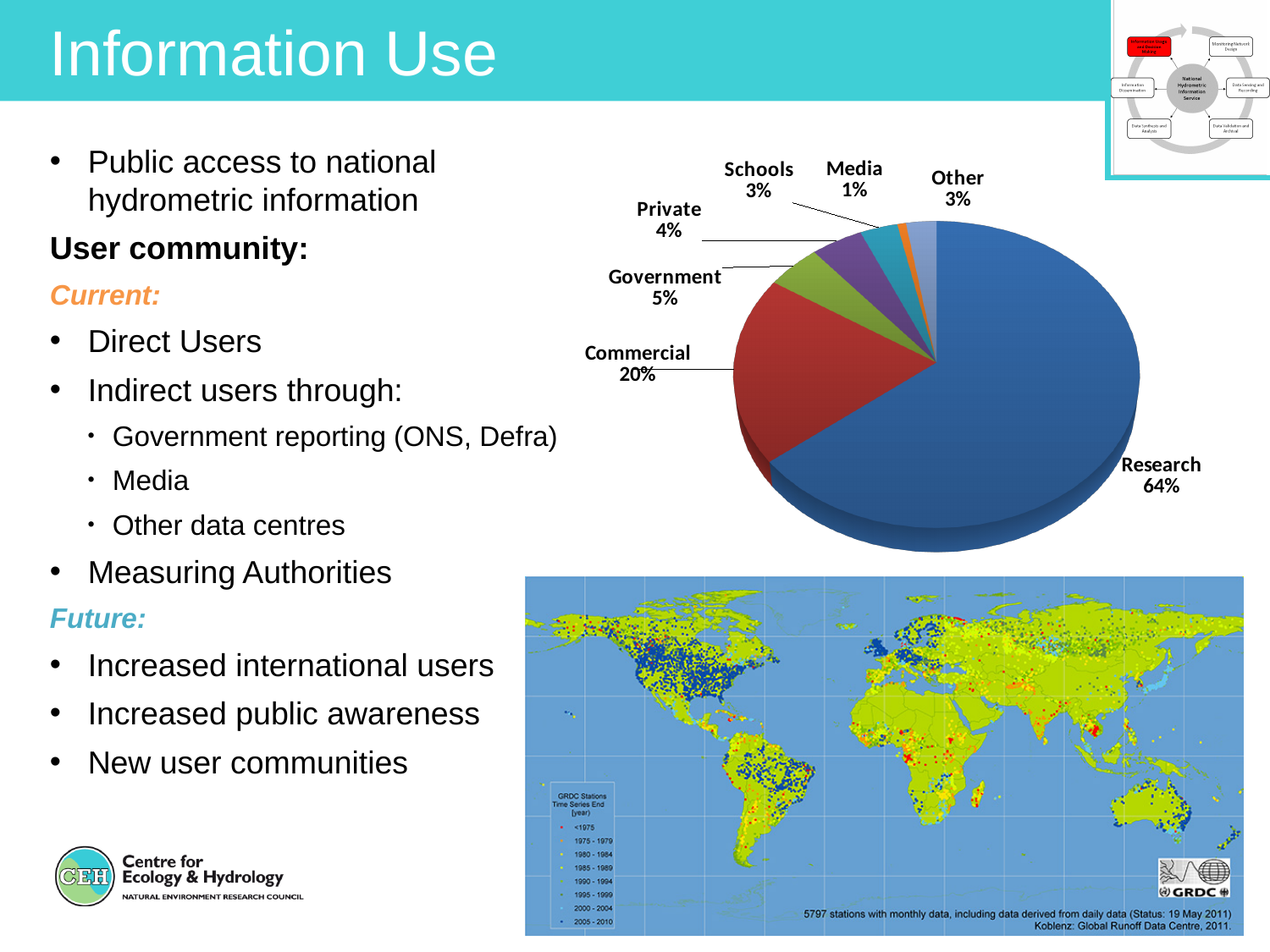
Which is larger, the share for Private or the share for Government? Government What share of the pie does Research account for? 64% What is the combined share of Schools and Other? 6% What percentage is shown for Government? 5% What colour is the Research slice of the pie? blue What is the difference in percentage points between Research and Commercial? 44 What kind of chart is shown on the slide? pie chart What share of the pie does Commercial account for? 20% What percentage is shown for Media? 1% Which category has the largest slice of the pie? Research How many categories are shown in the pie chart? 7 Which category has the smallest slice of the pie? Media